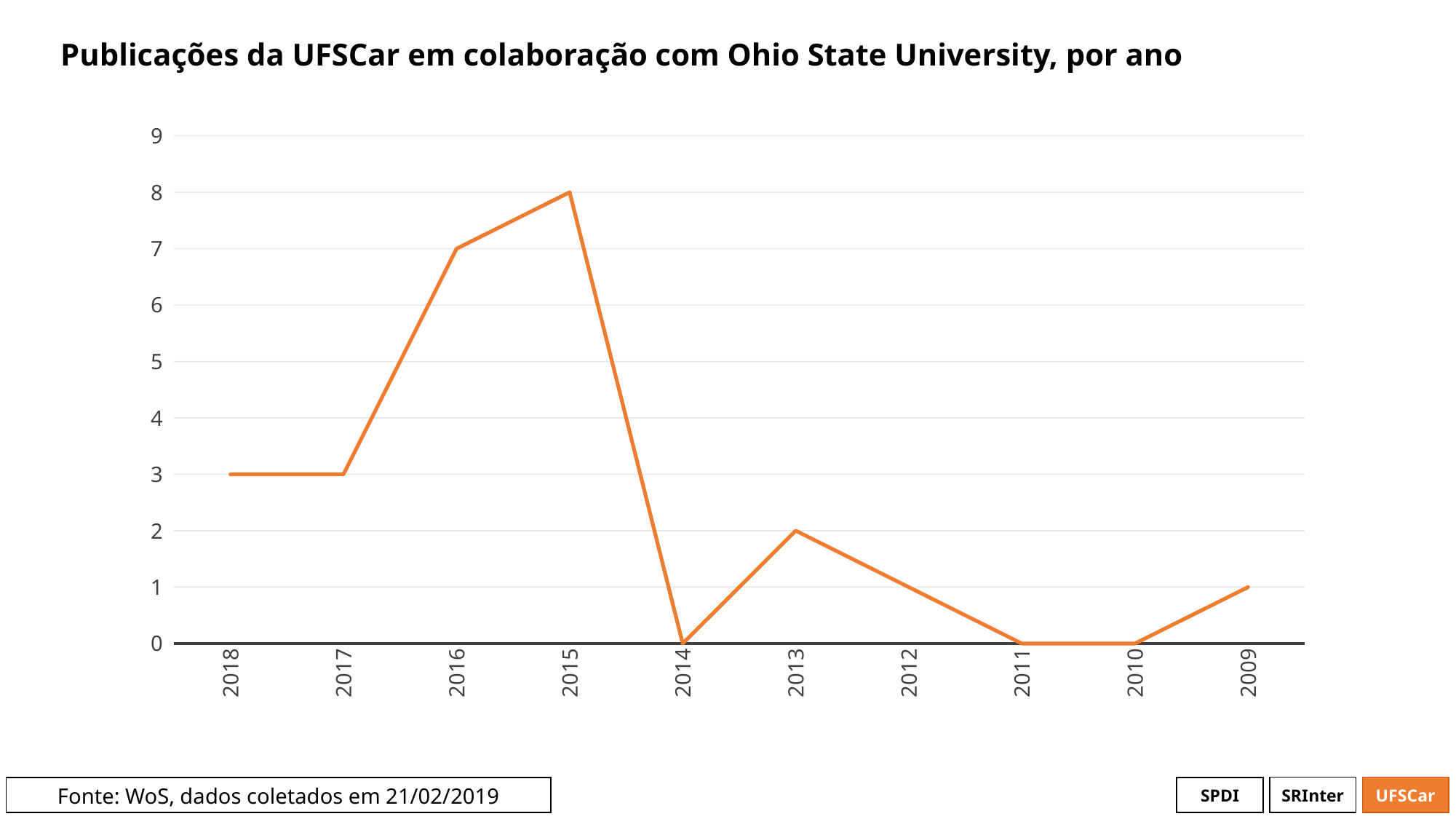
What kind of chart is shown on the slide? line chart What is the value for 2018? 3 What is the value for 2009? 1 What is the value for 2016? 7 What is the value for 2013? 2 Which is larger, the value for 2017 or the value for 2013? 2017 Which year has the highest value? 2015 What is the value for 2015? 8 What is the title of the chart? Publicações da UFSCar em colaboração com Ohio State University, por ano How many years have a value of 0? 3 How many years are shown on the x axis? 10 What is the difference between the values for 2015 and 2016? 1